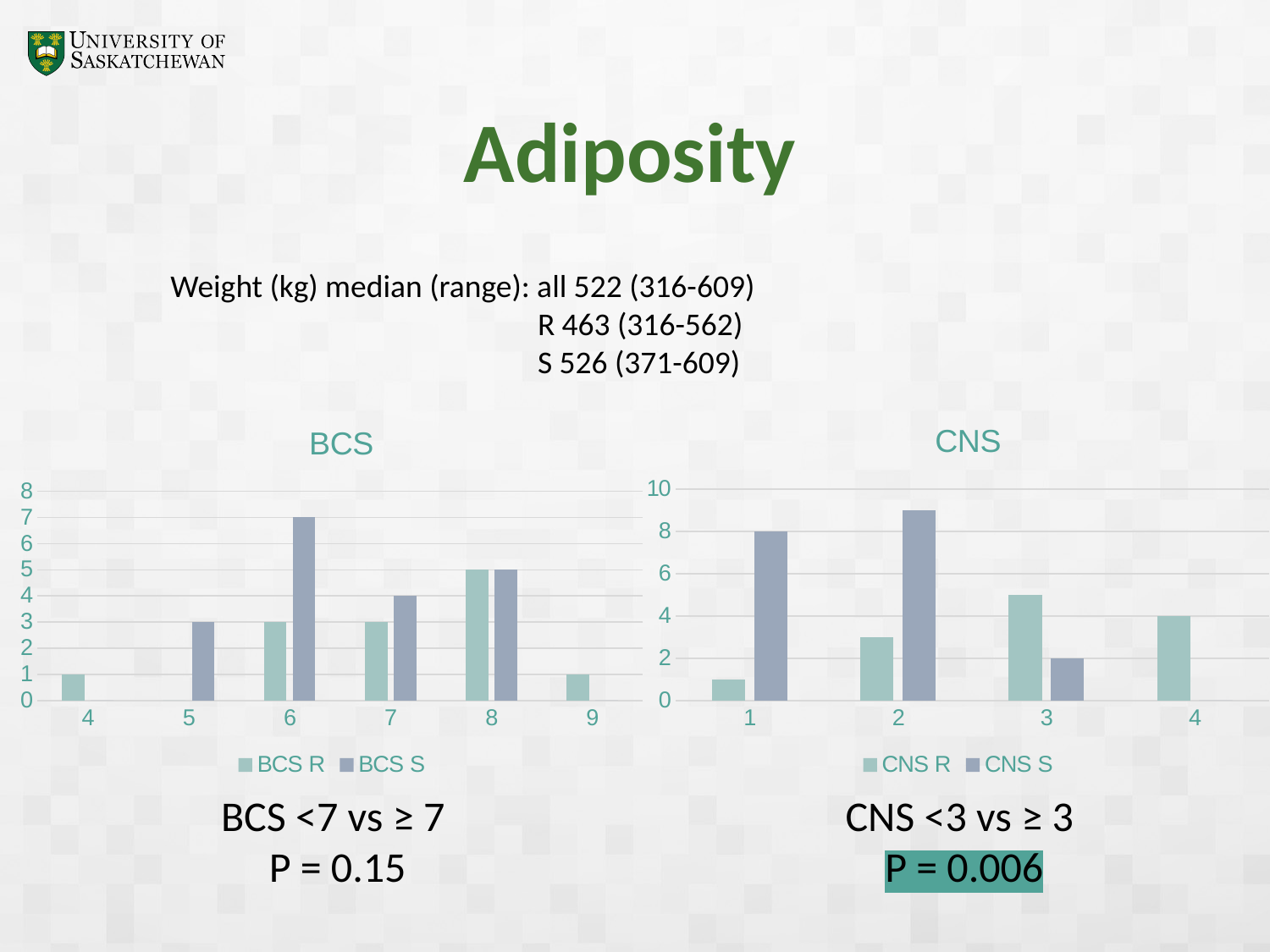
What type of chart is the CNS chart? Bar chart In the BCS chart, what is the value of BCS S at category 6? 7 In the BCS chart, what is the difference between BCS S and BCS R at category 6? 4 In the BCS chart, which is larger at category 7: BCS R or BCS S? BCS S In the CNS chart, what is the value of CNS S at category 1? 8 In the CNS chart, what is the value of CNS R at category 4? 4 In the CNS chart, which category has the highest CNS S bar? 2 In the BCS chart, how many categories are shown on the x axis? 6 In the CNS chart, how many series does the legend list? 2 In the BCS chart, which category has the highest BCS S bar? 6 In the BCS chart, what is the value of BCS R at category 8? 5 In the CNS chart, is the value of CNS S at category 2 greater or less than 8? greater